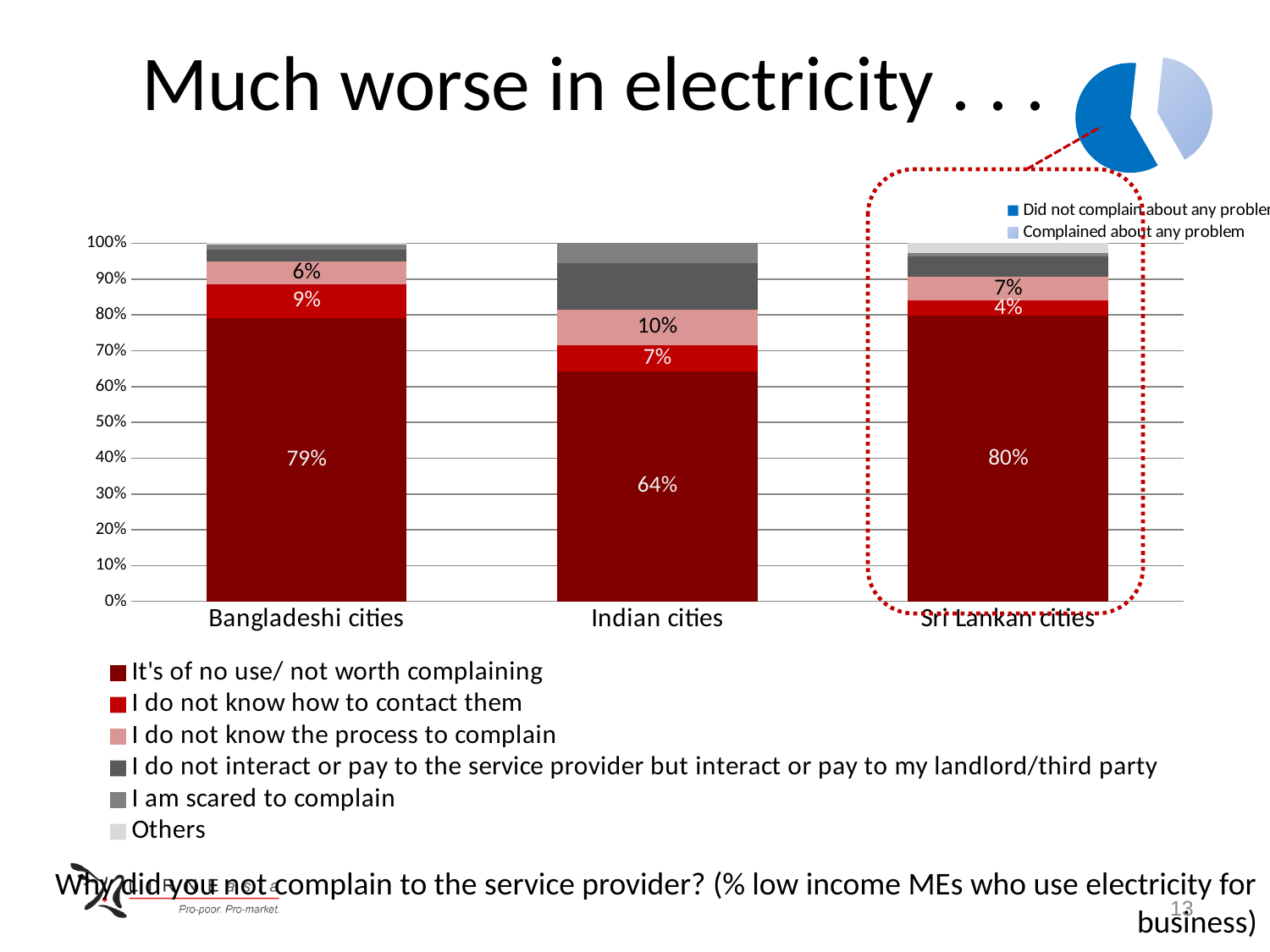
How many series does the legend of the stacked bar chart list? 6 How many city groups are shown on the x axis of the stacked bar chart? 3 In the stacked bar chart, what is the difference between the 'It's of no use/ not worth complaining' values for Bangladeshi cities and Indian cities? 15% In the stacked bar chart, what percentage of low income MEs in Bangladeshi cities said 'It's of no use/ not worth complaining'? 79% In the stacked bar chart, what is the value for 'I do not know the process to complain' in Indian cities? 10% In the stacked bar chart, which city group has the lowest share for 'It's of no use/ not worth complaining'? Indian cities In the stacked bar chart, what is the value for 'I do not know how to contact them' in Sri Lankan cities? 4% What is the title of the slide? Much worse in electricity . . . In the stacked bar chart, which city group has the highest share for 'It's of no use/ not worth complaining'? Sri Lankan cities In the stacked bar chart, is the 'I do not know how to contact them' value larger for Bangladeshi cities or Indian cities? Bangladeshi cities What kind of chart is the main chart on the slide? Stacked bar chart In the stacked bar chart, what is the value for 'I do not know the process to complain' in Sri Lankan cities? 7%